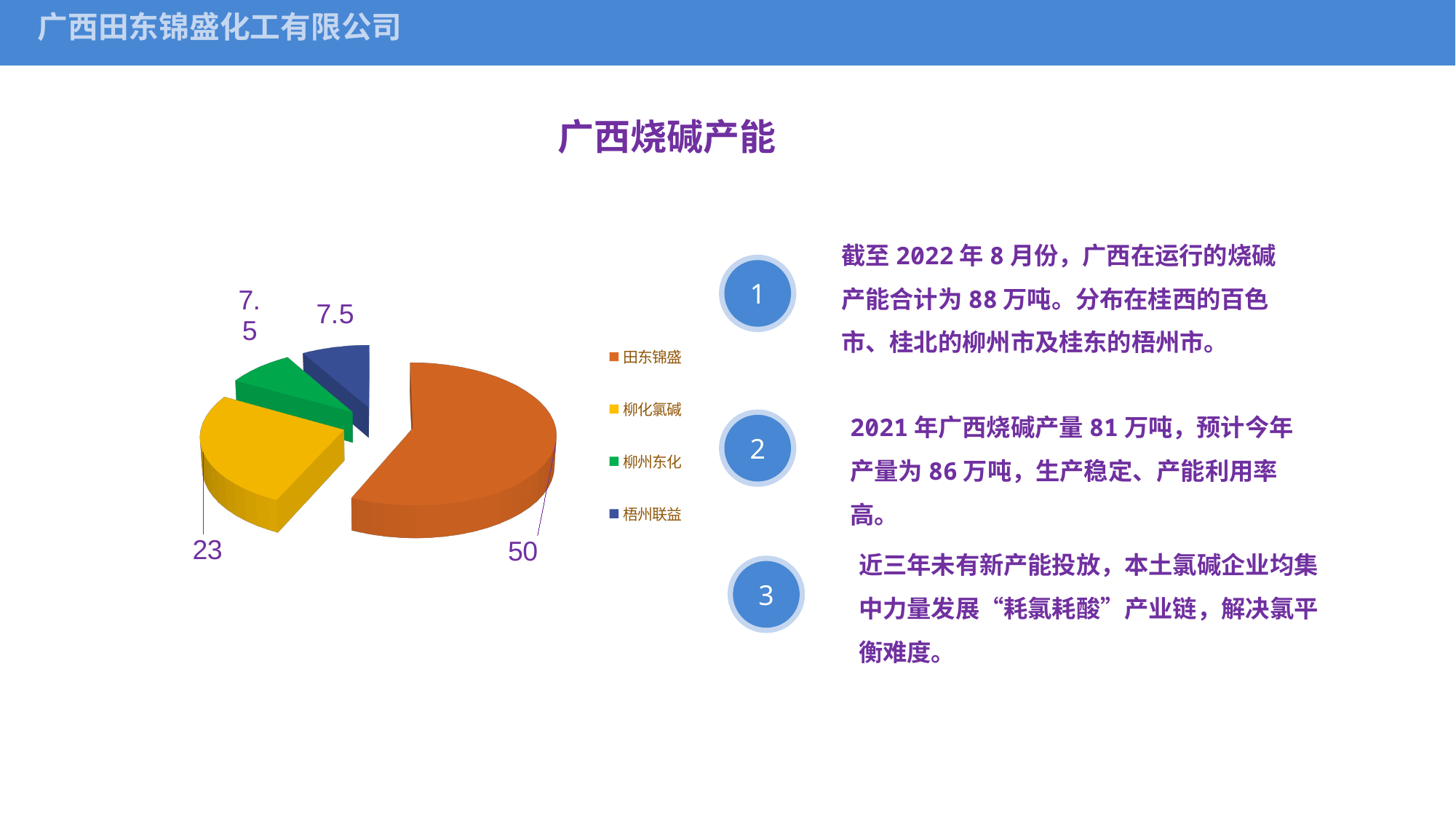
Which is larger, the value for 柳化氯碱 or the value for 梧州联益? 柳化氯碱 What is the value for 柳化氯碱 in the pie chart? 23 Which category has the largest slice in the pie chart? 田东锦盛 How many categories does the pie chart legend list? 4 What is the value for 柳州东化 in the pie chart? 7.5 What is the value for 梧州联益 in the pie chart? 7.5 What is the difference between the values for 田东锦盛 and 柳化氯碱? 27 What is the value for 田东锦盛 in the pie chart? 50 What is the difference between the values for 柳化氯碱 and 柳州东化? 15.5 What type of chart is shown on the slide? Pie chart What is the title of the chart? 广西烧碱产能 Which two categories share the smallest value in the pie chart? 柳州东化 and 梧州联益